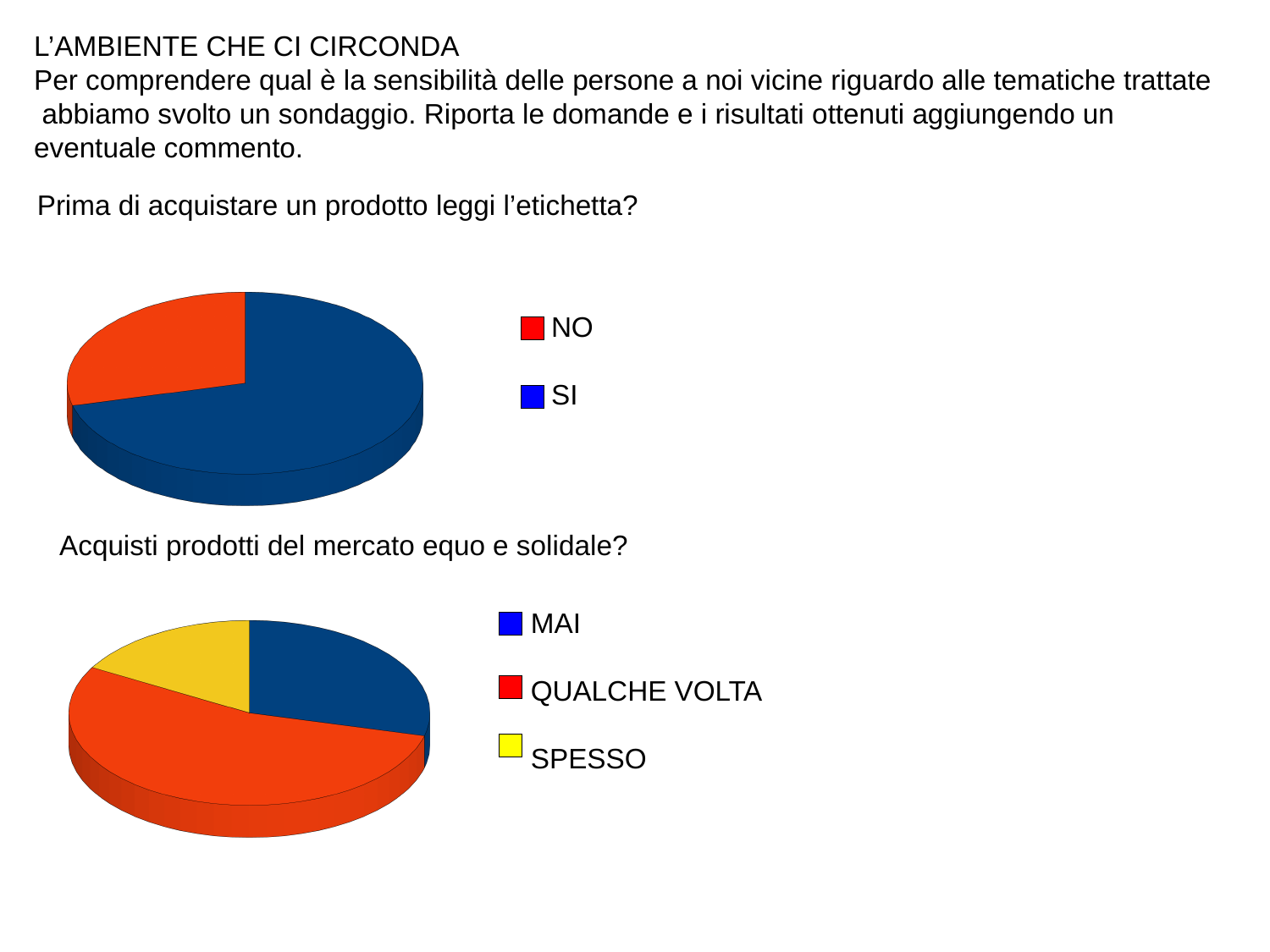
How many entries does the legend of the bottom pie chart ("Acquisti prodotti del mercato equo e solidale?") list? 3 In the top pie chart ("Prima di acquistare un prodotto leggi l'etichetta?"), which answer has the smallest slice? NO In the top pie chart ("Prima di acquistare un prodotto leggi l'etichetta?"), how many slices does the pie have? 2 What kind of chart is shown under the question "Prima di acquistare un prodotto leggi l'etichetta?"? Pie chart In the bottom pie chart ("Acquisti prodotti del mercato equo e solidale?"), what colour represents the answer SPESSO? Yellow What kind of chart is shown under the question "Acquisti prodotti del mercato equo e solidale?"? Pie chart In the bottom pie chart ("Acquisti prodotti del mercato equo e solidale?"), which answer has the smallest slice? SPESSO In the bottom pie chart ("Acquisti prodotti del mercato equo e solidale?"), which answer has the largest slice? QUALCHE VOLTA In the bottom pie chart ("Acquisti prodotti del mercato equo e solidale?"), which slice is larger, MAI or SPESSO? MAI In the top pie chart ("Prima di acquistare un prodotto leggi l'etichetta?"), what colour represents the answer NO? Red How many entries does the legend of the top pie chart ("Prima di acquistare un prodotto leggi l'etichetta?") list? 2 In the top pie chart ("Prima di acquistare un prodotto leggi l'etichetta?"), which answer has the largest slice? SI